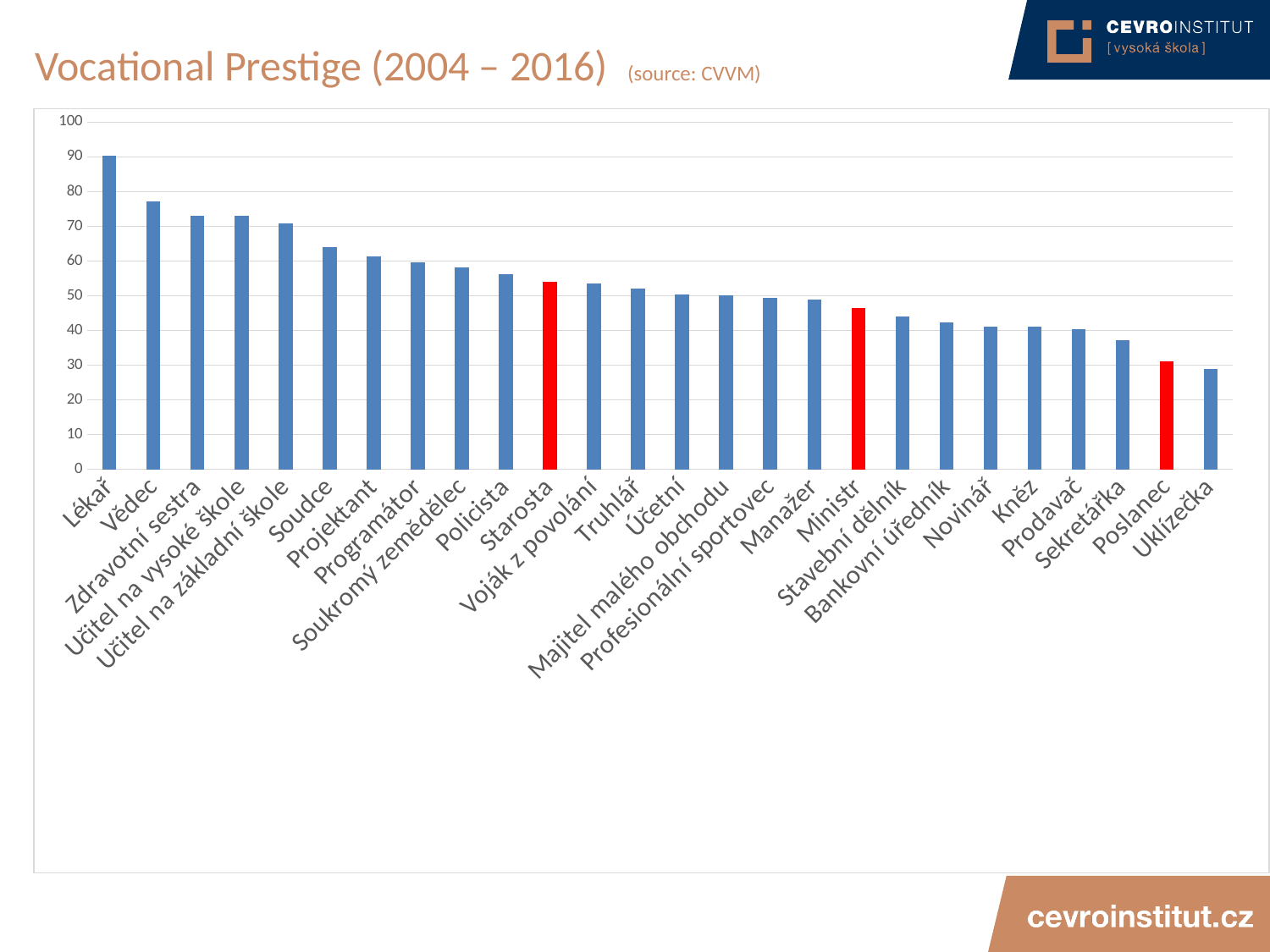
Is the value for Poslanec greater or less than 40? less Which occupation has the highest vocational prestige value? Lékař How many occupations are plotted on the chart? 26 Which has the larger value, Starosta or Poslanec? Starosta Is the value for Soudce greater or less than 60? greater What kind of chart is shown on the slide? bar chart Is the value for Lékař greater or less than 80? greater Which occupation has the lowest vocational prestige value? Uklízečka Do the values rise or fall moving from left to right along the x axis? fall What is the title of the chart on the slide? Vocational Prestige (2004 – 2016) How many bars are coloured red on the chart? 3